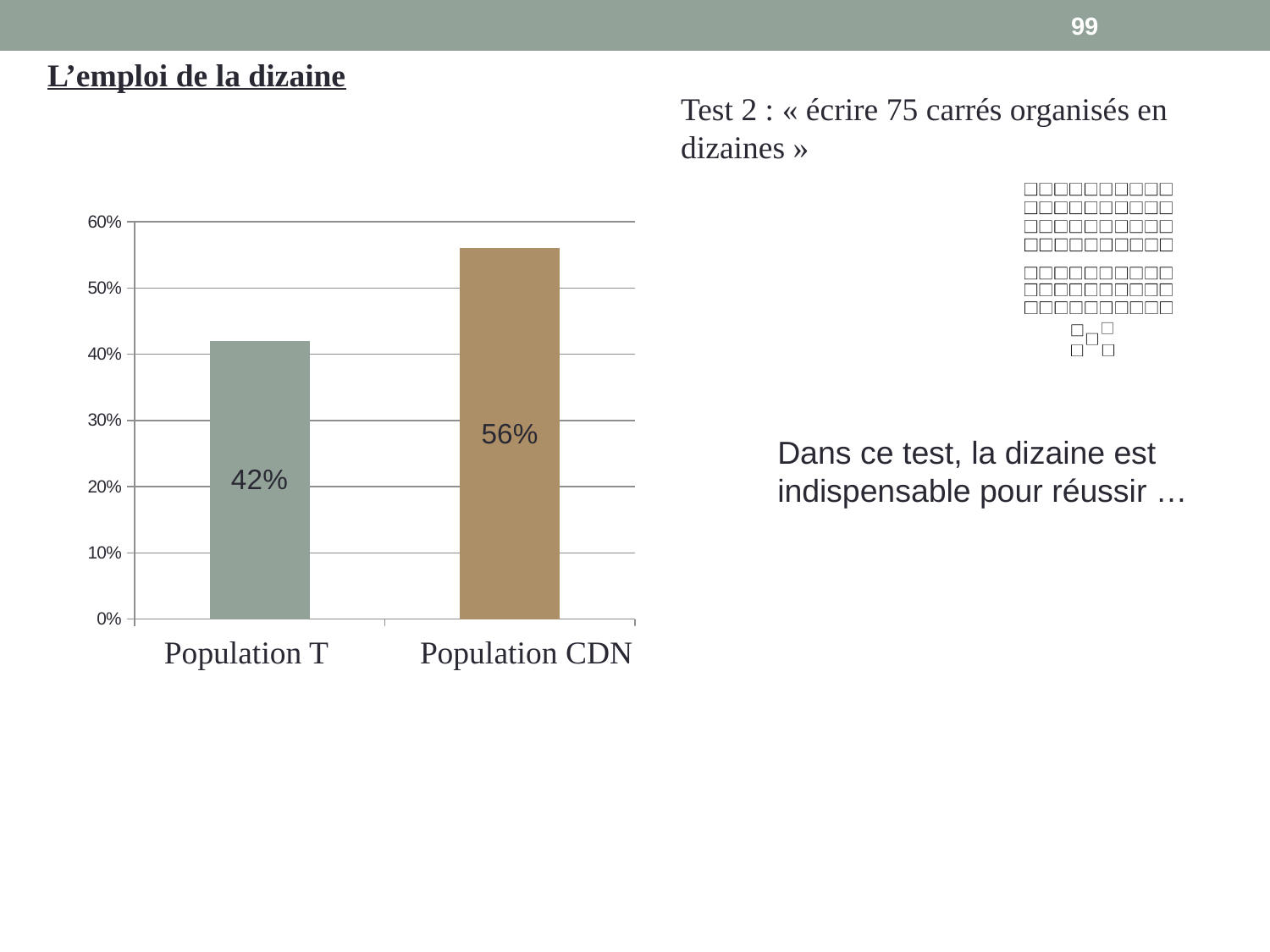
What kind of chart is shown on the slide? bar chart How many categories are shown on the chart? 2 What is the highest value shown on the vertical axis of the chart? 60% What is the difference between the values for Population CDN and Population T? 14% Which is larger, the value for Population T or the value for Population CDN? Population CDN Which category has the lowest value? Population T What colour is the bar for Population CDN? brown What is the value for Population T? 42% Is the value for Population T greater or less than 50%? less Which category has the highest value? Population CDN Is the value for Population CDN greater or less than 50%? greater What is the value for Population CDN? 56%